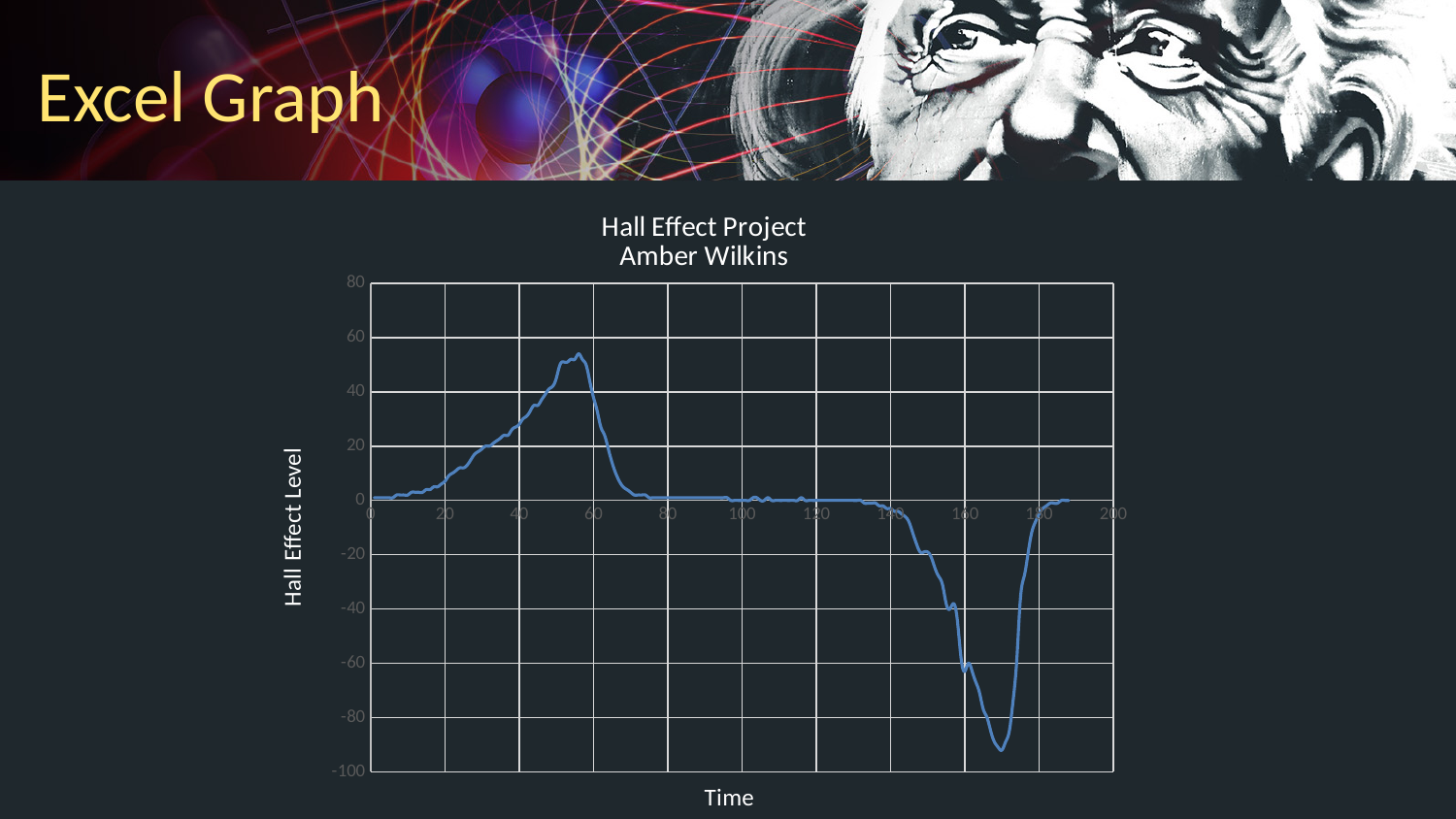
Does the line rise or fall between Time 0 and Time 50? rise What kind of chart is shown on the slide? line chart Is the highest value reached by the line greater or less than 60? less Is the value at Time 40 greater or less than 0? greater Does the line rise or fall between Time 140 and Time 170? fall Is the highest value reached by the line greater or less than 40? greater What is the label of the vertical axis? Hall Effect Level What is the title of the chart? Hall Effect Project Amber Wilkins